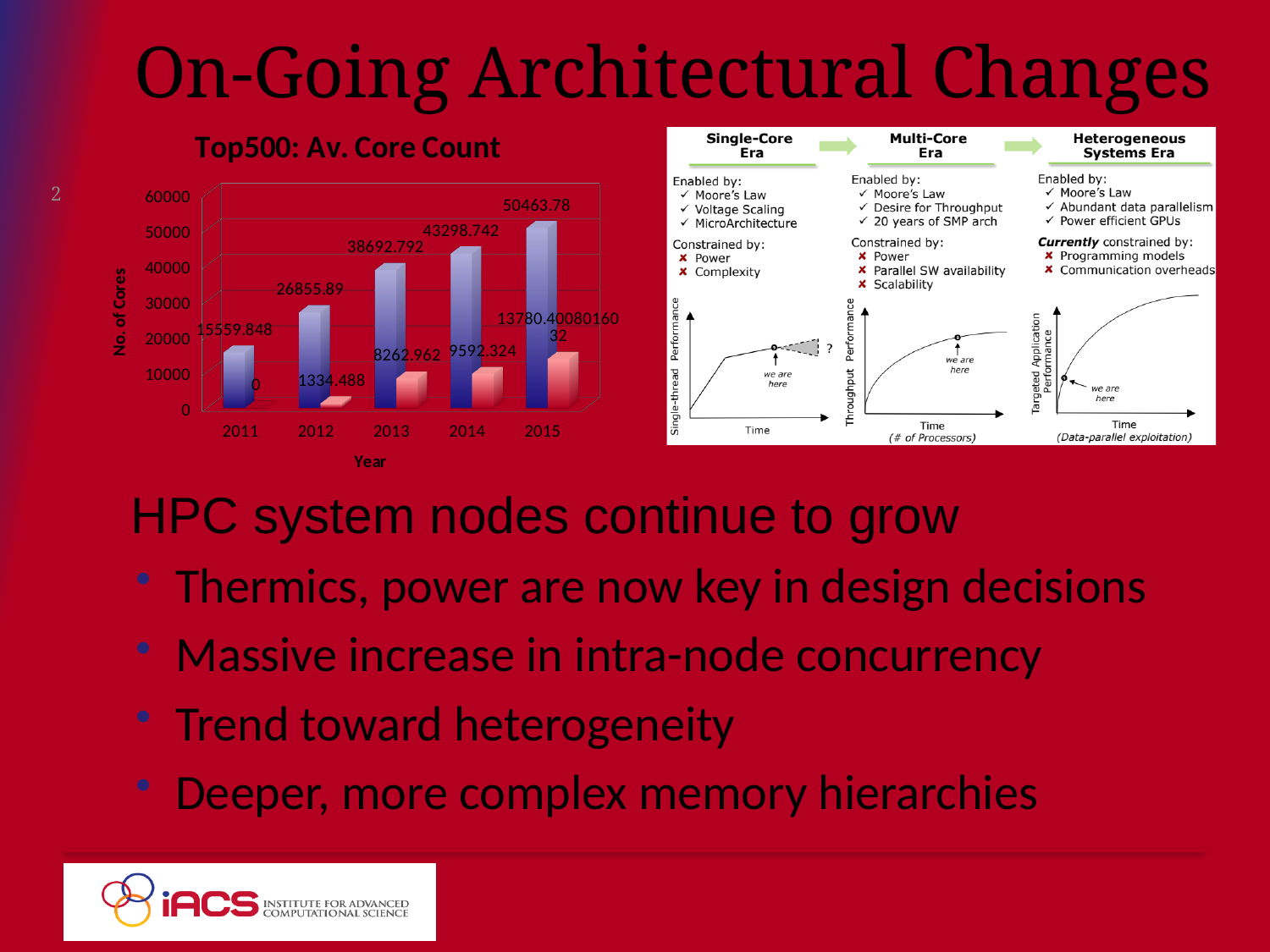
How many years are shown on the x axis of the 'Top500: Av. Core Count' chart? 5 In the 'Top500: Av. Core Count' chart, what is the value of the blue bar for 2011? 15559.848 In the 'Top500: Av. Core Count' chart, is the blue bar for 2014 greater or less than 40000? greater In the 'Top500: Av. Core Count' chart, what is the difference between the blue bar values for 2015 and 2011? 34903.932 In the 'Top500: Av. Core Count' chart, what is the value of the pink bar for 2014? 9592.324 What kind of chart is the 'Top500: Av. Core Count' chart? bar chart In the 'Top500: Av. Core Count' chart, which year has the lowest blue bar? 2011 In the 'Top500: Av. Core Count' chart, do the blue bars rise or fall from 2011 to 2015? rise In the 'Top500: Av. Core Count' chart, what is the value of the pink bar for 2012? 1334.488 In the 'Top500: Av. Core Count' chart, which year has the highest blue bar? 2015 What is the y-axis title of the 'Top500: Av. Core Count' chart? No. of Cores In the 'Top500: Av. Core Count' chart, what is the value of the blue bar for 2015? 50463.78